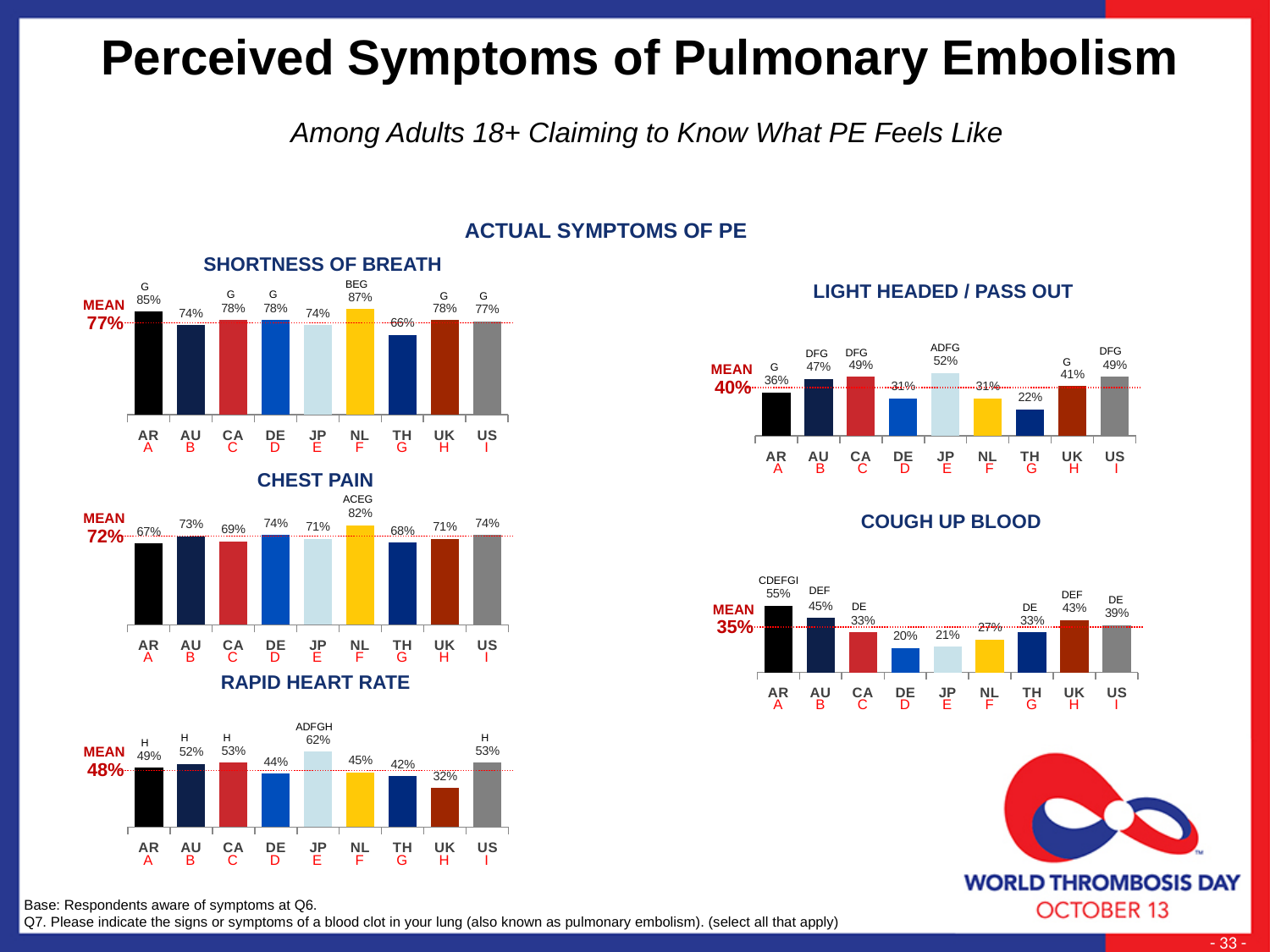
In the Cough Up Blood chart, what is the value for DE? 20% In the Light Headed / Pass Out chart, what is the mean value shown? 40% In the Chest Pain chart, what is the difference between the values for NL and AR? 15% In the Chest Pain chart, what is the value for NL? 82% In the Shortness of Breath chart, which country has the lowest value? TH In the Rapid Heart Rate chart, what is the value for UK? 32% How many countries are shown in the Chest Pain chart? 9 What type of chart is the Shortness of Breath chart? Bar chart In the Light Headed / Pass Out chart, which country has the lowest value? TH In the Shortness of Breath chart, what is the value for NL? 87% In the Rapid Heart Rate chart, which country has the highest value? JP In the Cough Up Blood chart, which is larger, the value for AR or the value for AU? AR